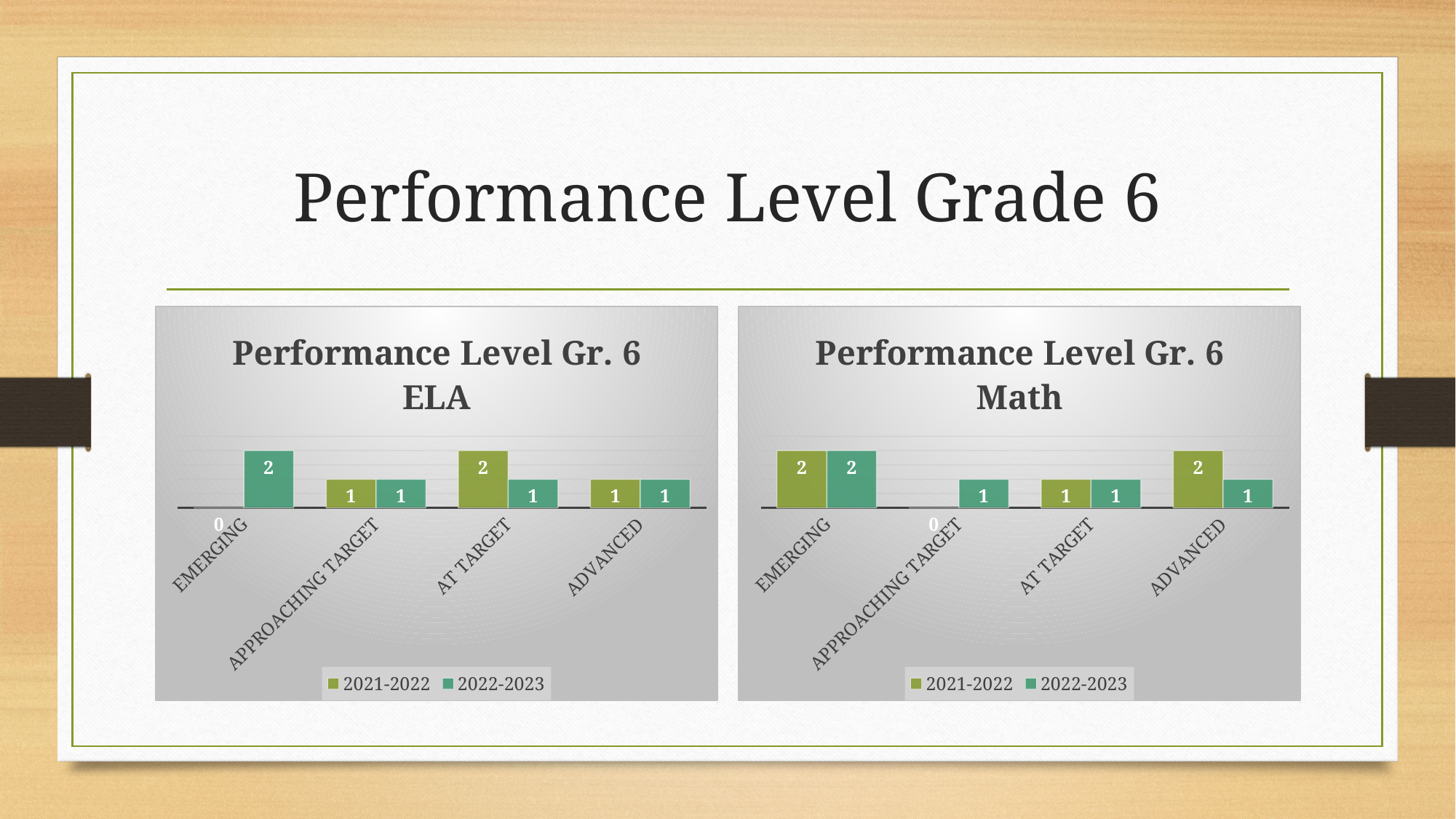
In the Performance Level Gr. 6 ELA chart, what is the value for EMERGING in 2022-2023? 2 In the Performance Level Gr. 6 ELA chart, what is the value for AT TARGET in 2021-2022? 2 What kind of chart is the Performance Level Gr. 6 Math chart? Bar chart In the Performance Level Gr. 6 Math chart, which is larger for ADVANCED: the 2021-2022 value or the 2022-2023 value? 2021-2022 In the Performance Level Gr. 6 Math chart, what is the value for ADVANCED in 2021-2022? 2 How many series does the legend of the Performance Level Gr. 6 ELA chart list? 2 In the Performance Level Gr. 6 Math chart, what is the value for APPROACHING TARGET in 2022-2023? 1 How many categories are shown on the x axis of the Performance Level Gr. 6 Math chart? 4 In the Performance Level Gr. 6 Math chart, which category has the lowest value for 2021-2022? APPROACHING TARGET In the Performance Level Gr. 6 ELA chart, what is the value for EMERGING in 2021-2022? 0 In the Performance Level Gr. 6 ELA chart, which category has the highest value for 2022-2023? EMERGING In the Performance Level Gr. 6 ELA chart, what is the difference between the 2021-2022 and 2022-2023 values for AT TARGET? 1